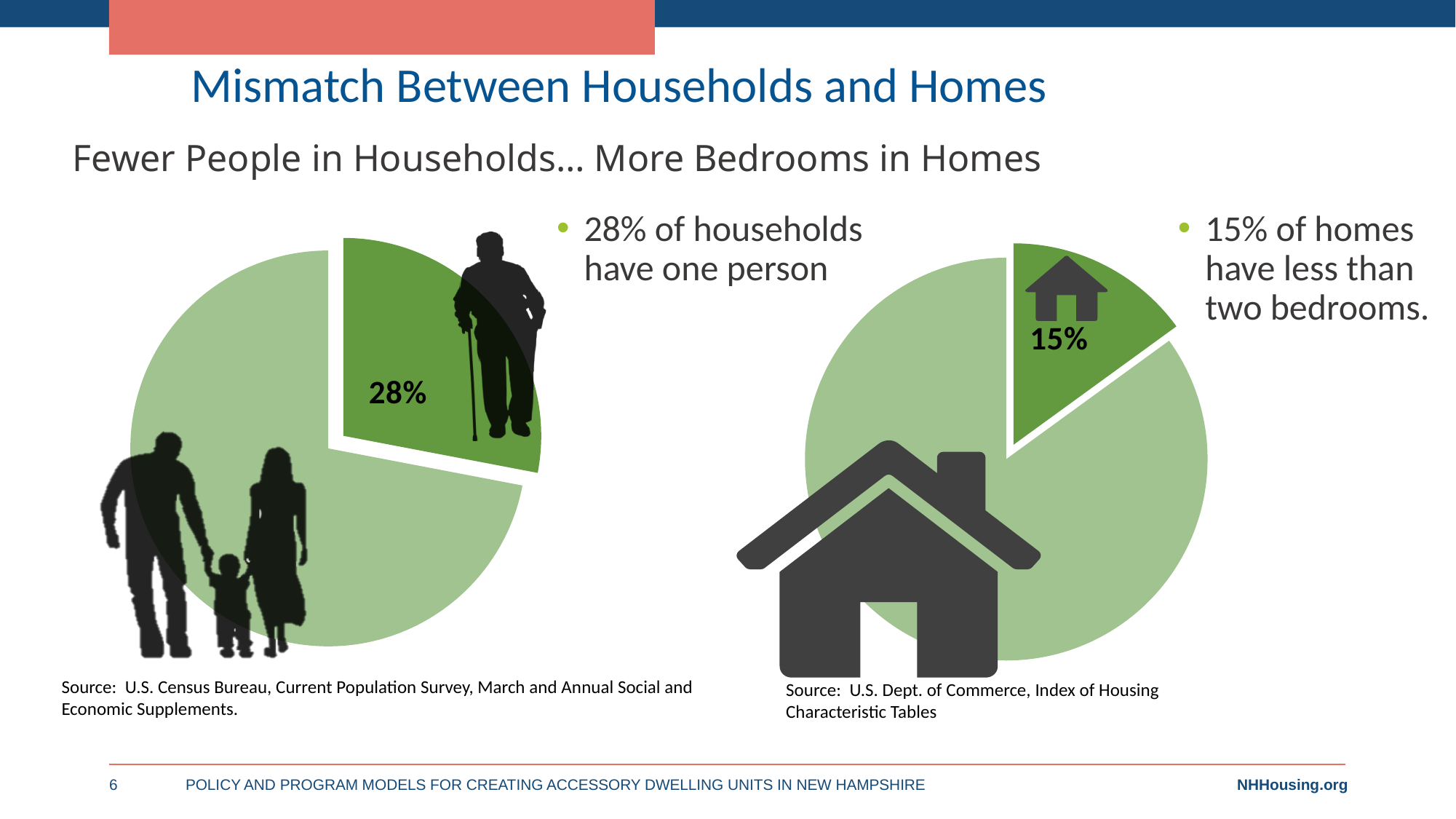
On the right pie chart, what share of homes have less than two bedrooms? 15% On the left pie chart, what share of households have one person? 28% On the right pie chart, what percentage is shown on the pulled-out slice? 15% How many slices does the right pie chart have? 2 Which labelled slice is larger: the 28% slice on the left pie chart or the 15% slice on the right pie chart? The 28% slice on the left pie chart What kind of chart is used on the right side of the slide? Pie chart What kind of chart is used on the left side of the slide? Pie chart On the left pie chart, what percentage is shown on the pulled-out slice? 28% On the right pie chart, what colour is the pulled-out 15% slice compared with the rest of the pie? Darker green What is the difference in percentage points between the labelled slice on the left pie chart and the labelled slice on the right pie chart? 13 percentage points How many slices does the left pie chart have? 2 On the left pie chart, is the labelled slice the smaller or the larger of the two slices? Smaller